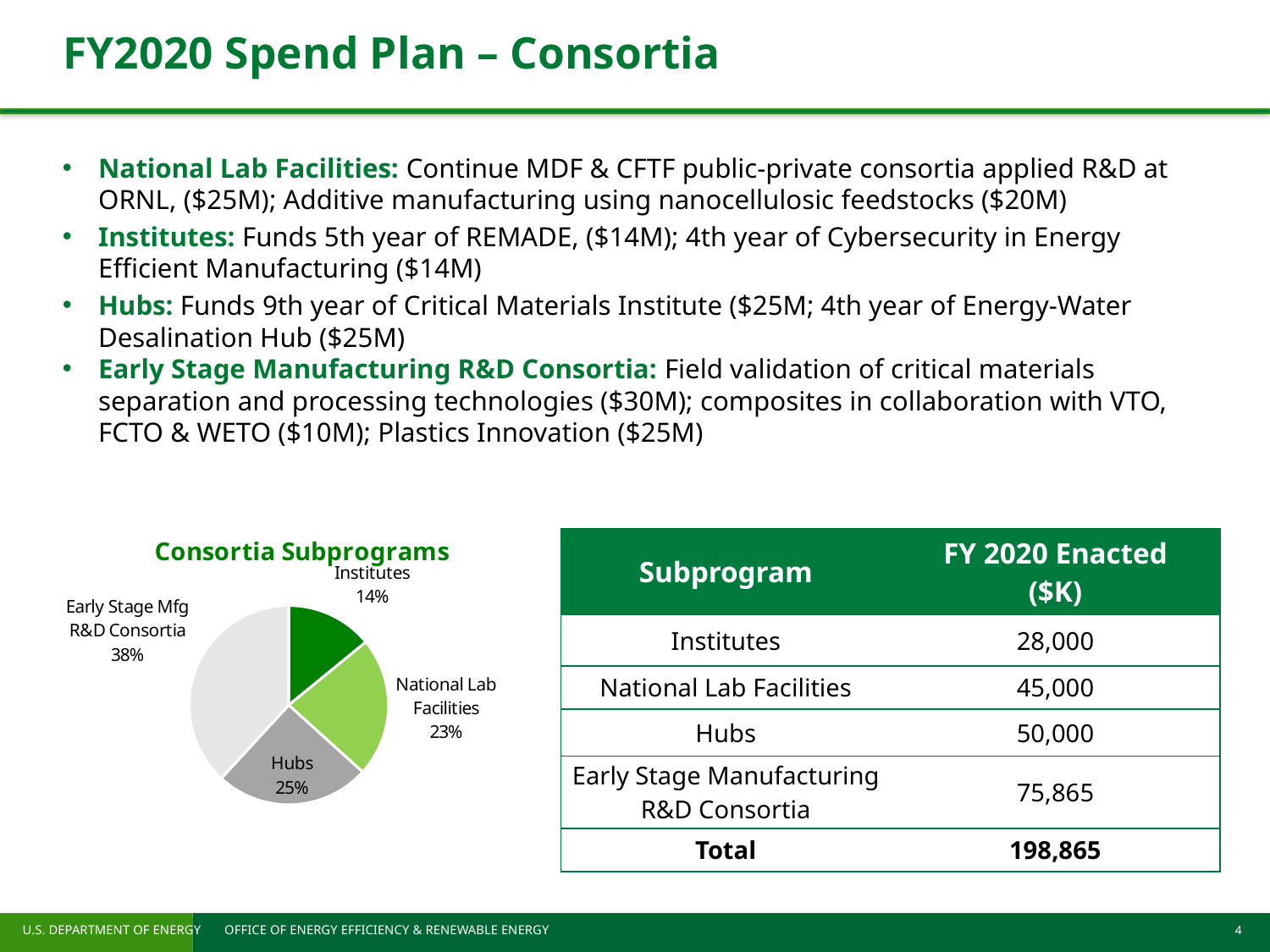
Which slice of the pie chart is the smallest? Institutes Which slice is larger, Hubs or National Lab Facilities? Hubs What is the difference in percentage points between the National Lab Facilities slice and the Institutes slice? 9 What share of the pie does Institutes represent? 14% Which slice of the pie chart is the largest? Early Stage Mfg R&D Consortia What share of the pie does Hubs represent? 25% What is the title of the chart? Consortia Subprograms How many slices does the pie chart have? 4 What share of the pie does National Lab Facilities represent? 23% What type of chart is shown on the slide? pie chart What is the difference in percentage points between the Early Stage Mfg R&D Consortia slice and the Hubs slice? 13